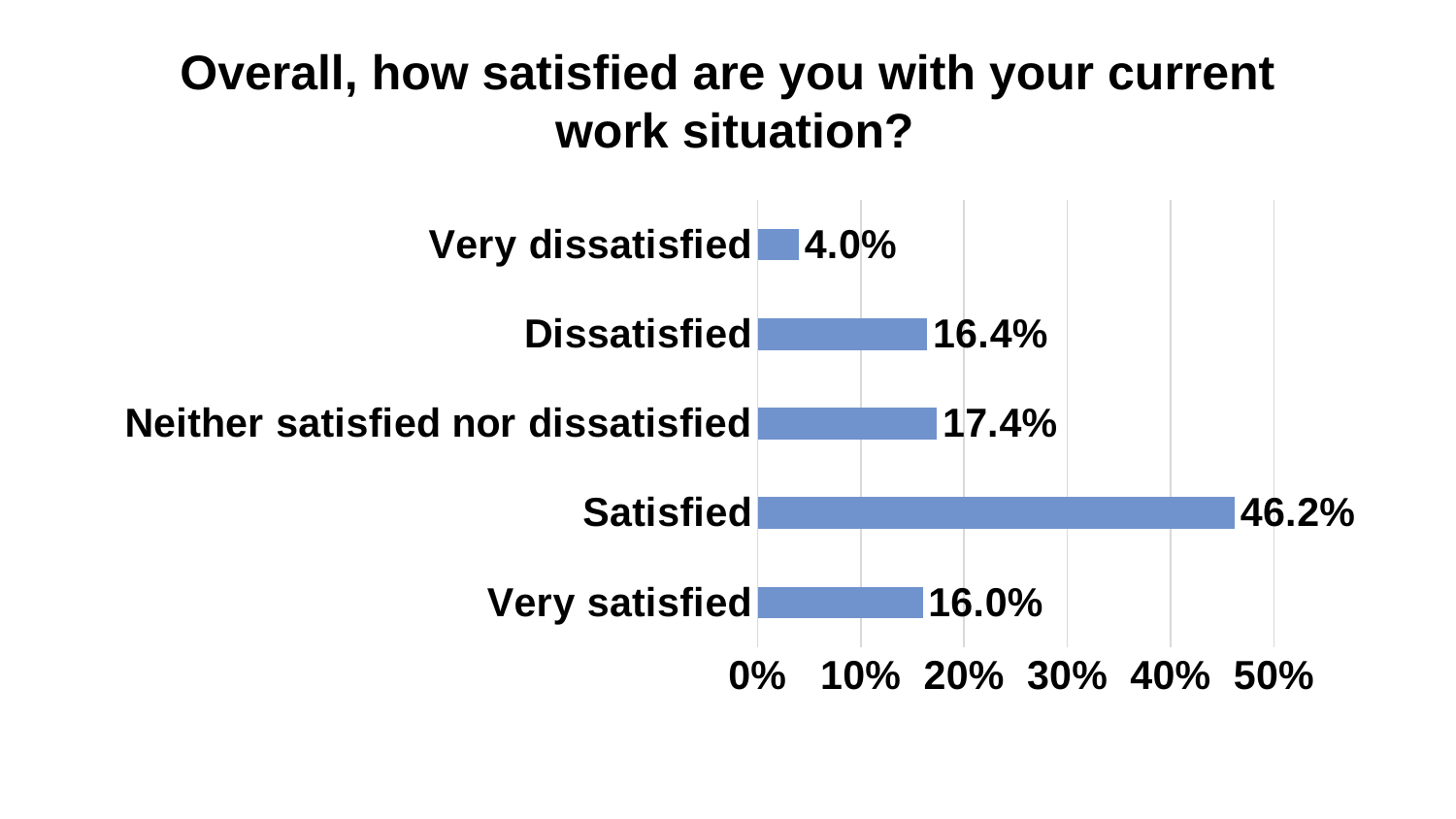
Which is larger, the value for "Dissatisfied" or the value for "Very satisfied"? Dissatisfied What type of chart is shown on the slide? Bar chart What is the difference between "Dissatisfied" and "Very dissatisfied"? 12.4% What percentage answered "Neither satisfied nor dissatisfied"? 17.4% Which response category has the highest percentage? Satisfied What is the difference between the "Satisfied" and "Very satisfied" percentages? 30.2% What is the title of the chart? Overall, how satisfied are you with your current work situation? Which response category has the lowest percentage? Very dissatisfied What is the value for "Very dissatisfied"? 4.0% What percentage of respondents answered "Satisfied"? 46.2% How many response categories are shown in the chart? 5 Is the value for "Satisfied" greater or less than 40%? greater